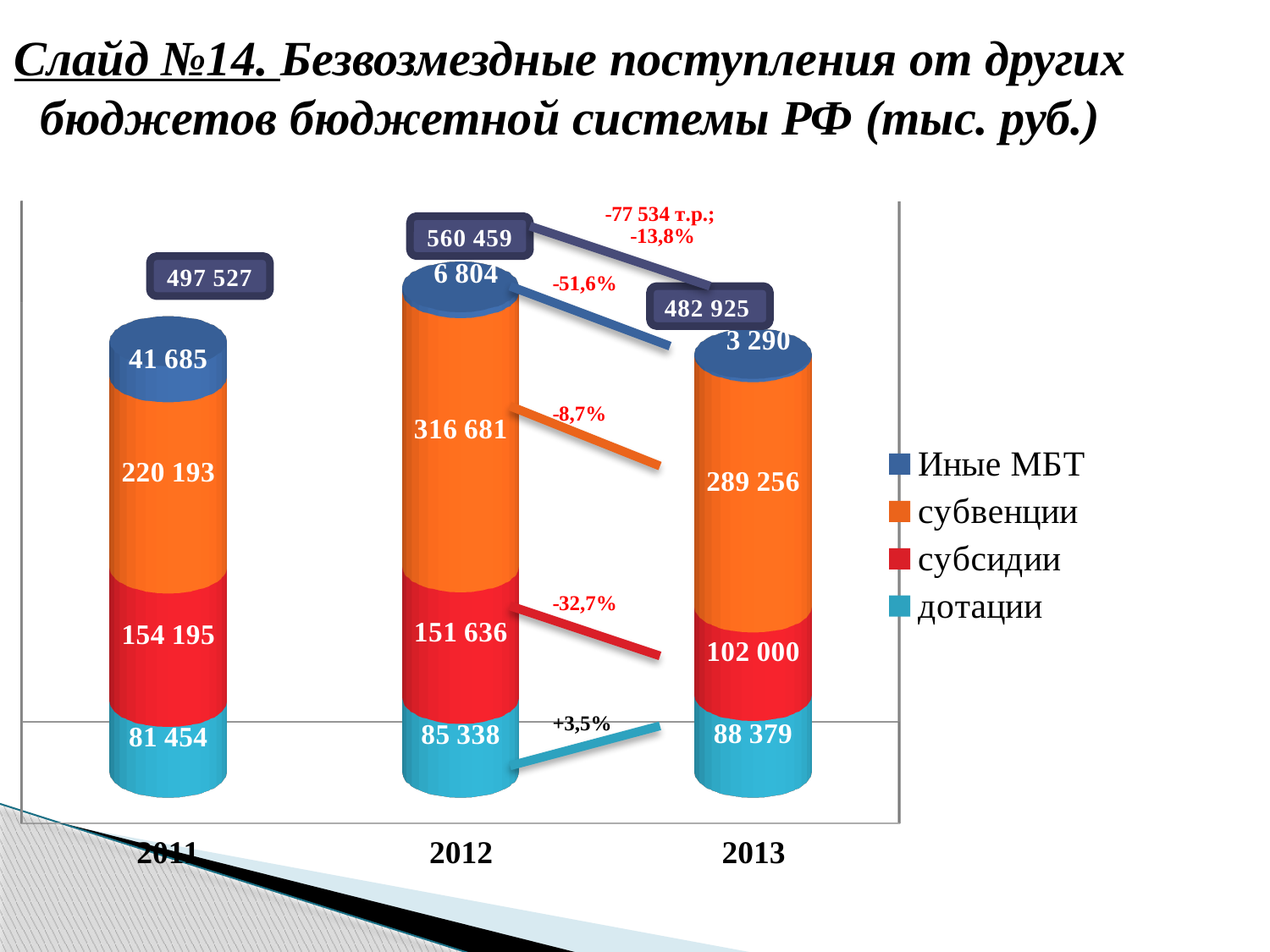
How many series does the legend list? 4 Which is larger: дотации in 2012 or дотации in 2013? дотации in 2013 What is the value of Иные МБТ for 2013? 3 290 What is the value of субсидии for 2013? 102 000 Which year has the highest total of безвозмездные поступления? 2012 What is the total of the stacked bar for 2013? 482 925 What kind of chart is shown on the slide? Stacked bar chart What is the value of субвенции for 2012? 316 681 Which year has the lowest value for Иные МБТ? 2013 What is the total of the stacked bar for 2012? 560 459 What is the difference between субсидии in 2011 and субсидии in 2013? 52 195 What is the value of дотации for 2011? 81 454